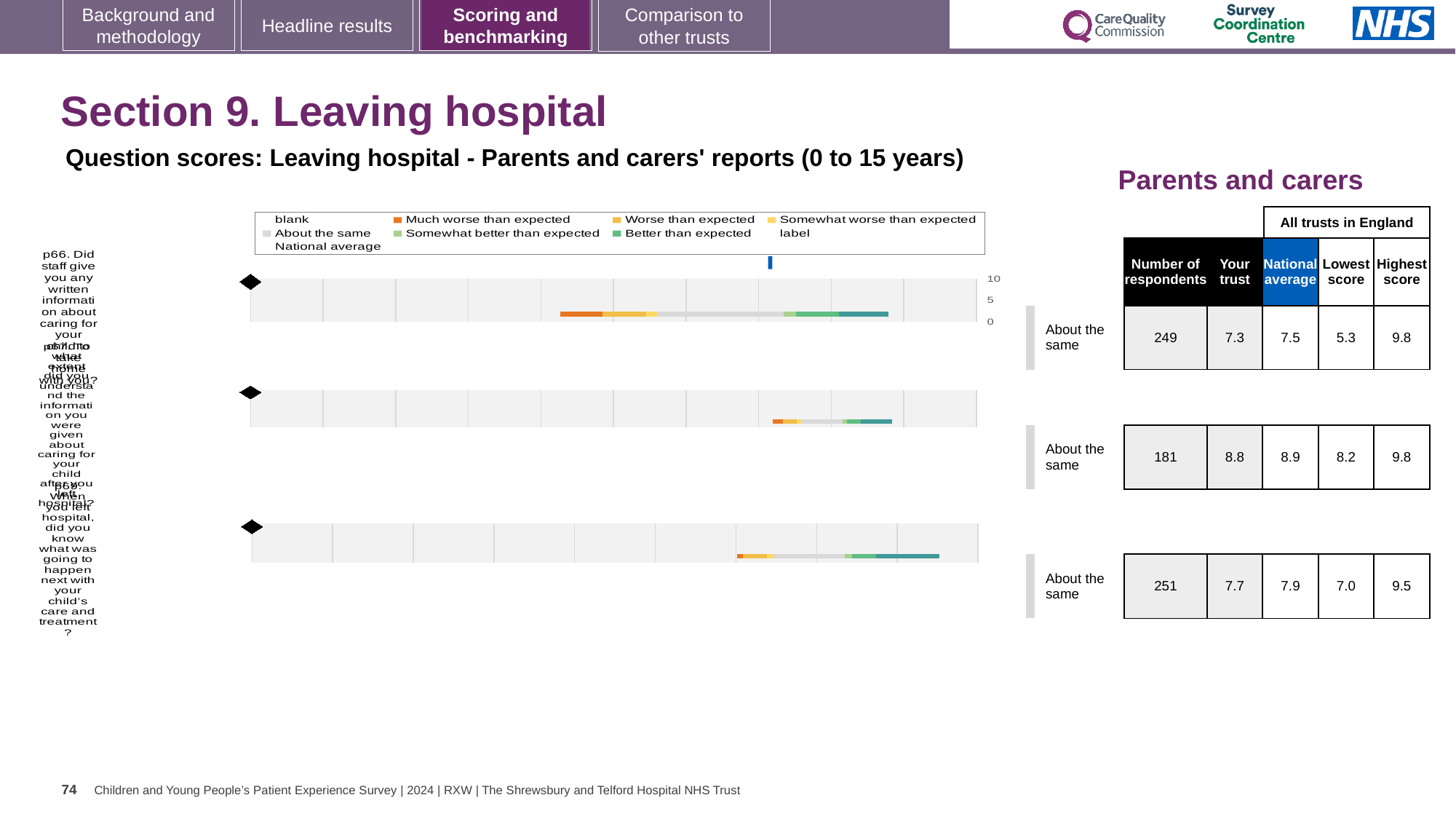
Which row has the highest 'Your trust' score? the second row (181 respondents), 8.8 In the table, what is the lowest score for the first row (249 respondents)? 5.3 Is the 'Your trust' score in the second row (181 respondents) larger or smaller than the national average for that row? smaller In the table, what is the national average for the second row (181 respondents)? 8.9 What kind of chart is used to show the question scores on this slide? bar chart In the table, what is the highest score for the third row (251 respondents)? 9.5 What colour in the legend represents 'Much worse than expected'? orange What benchmark category is shown for all three questions? About the same What is the difference between the national average and 'Your trust' score in the third row (251 respondents)? 0.2 In the table, what is the 'Your trust' score for the first row (249 respondents)? 7.3 How many question charts are shown on the slide? 3 Which row has the lowest 'Your trust' score? the first row (249 respondents), 7.3